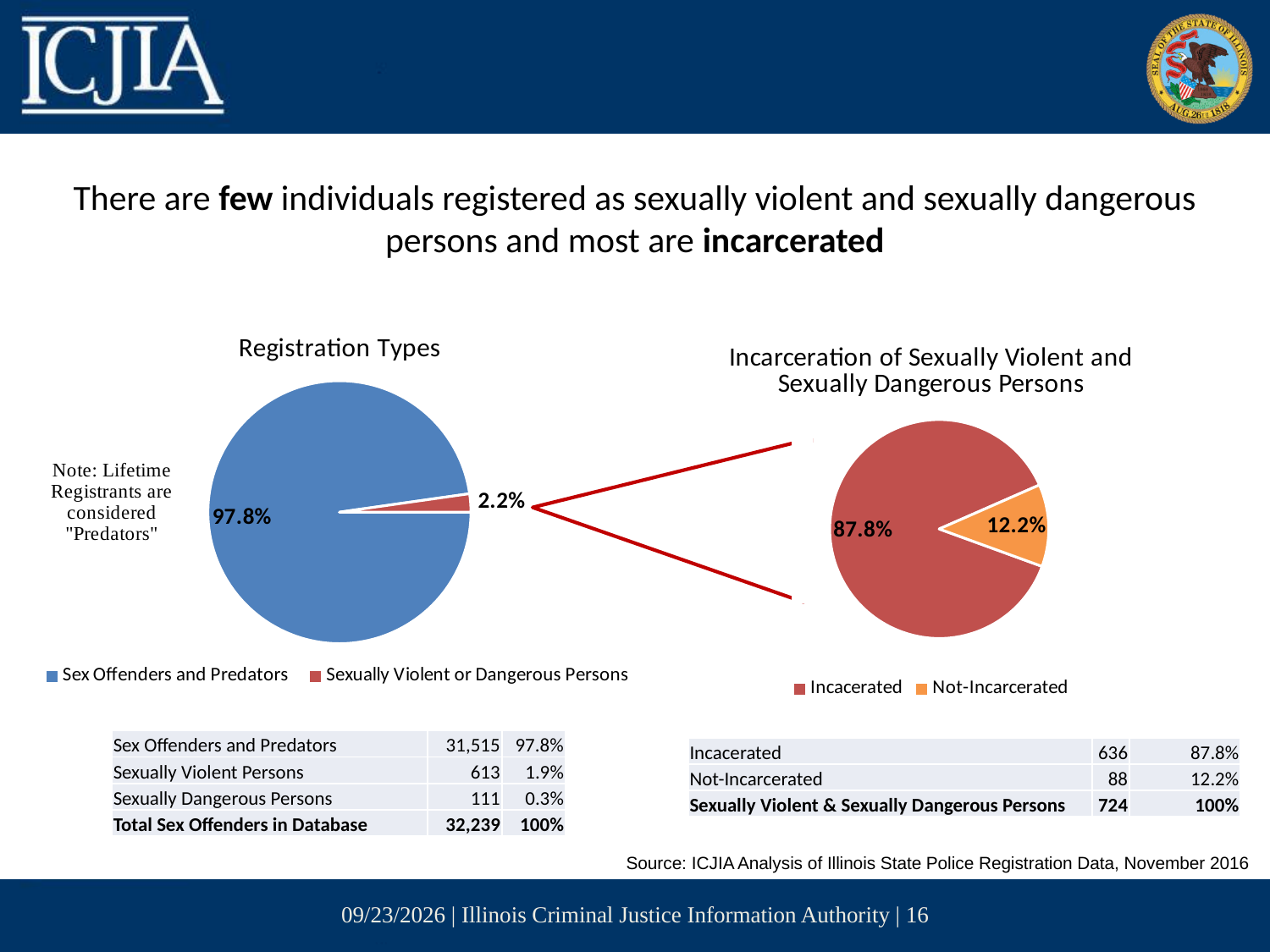
In the 'Registration Types' chart, what percentage is shown for Sexually Violent or Dangerous Persons? 2.2% In the 'Registration Types' chart, which slice is the largest? Sex Offenders and Predators In the 'Registration Types' chart, which is larger: Sex Offenders and Predators or Sexually Violent or Dangerous Persons? Sex Offenders and Predators How many entries does the legend of the 'Registration Types' chart list? 2 How many slices does the 'Incarceration of Sexually Violent and Sexually Dangerous Persons' chart have? 2 In the 'Incarceration of Sexually Violent and Sexually Dangerous Persons' chart, what is the difference in percentage points between Incarcerated and Not-Incarcerated? 75.6% In the 'Incarceration of Sexually Violent and Sexually Dangerous Persons' chart, which slice is the smallest? Not-Incarcerated In the 'Registration Types' chart, what percentage is shown for Sex Offenders and Predators? 97.8% In the 'Incarceration of Sexually Violent and Sexually Dangerous Persons' chart, what percentage is shown for Not-Incarcerated? 12.2% In the 'Incarceration of Sexually Violent and Sexually Dangerous Persons' chart, what colour is the Not-Incarcerated slice? Orange What type of chart is the 'Registration Types' chart? Pie chart In the 'Incarceration of Sexually Violent and Sexually Dangerous Persons' chart, what percentage is shown for Incarcerated? 87.8%